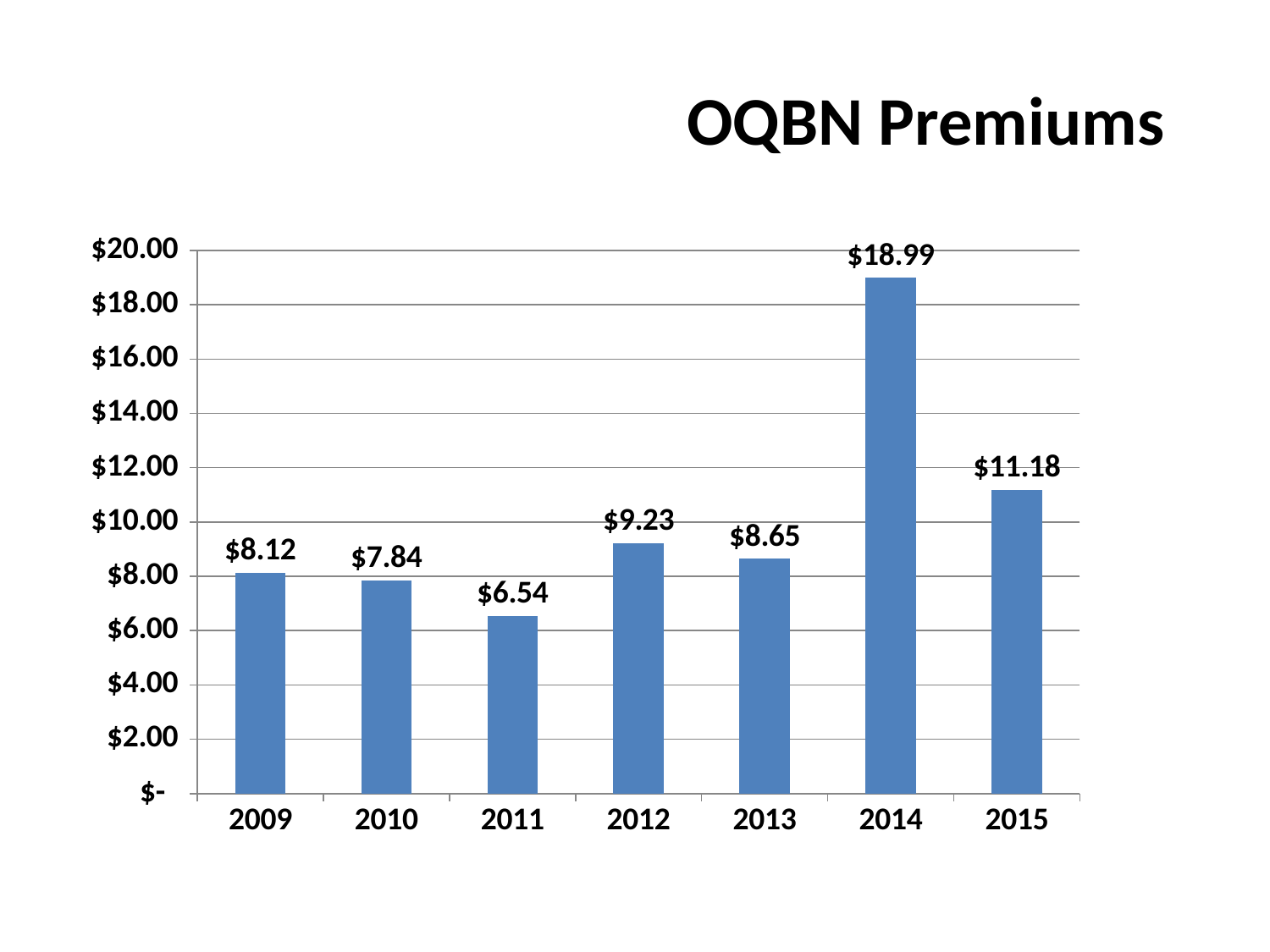
What is the OQBN premium for 2011? $6.54 What is the title of the chart? OQBN Premiums What is the difference between the 2009 and 2010 premiums? $0.28 How many years are shown on the chart? 7 Which year has a larger premium, 2012 or 2013? 2012 What is the OQBN premium for 2014? $18.99 What kind of chart is shown on the slide? Bar chart What is the OQBN premium for 2015? $11.18 Is the value for 2015 greater or less than $10.00? greater What is the difference between the 2014 and 2015 premiums? $7.81 Which year has the highest OQBN premium? 2014 Which year has the lowest OQBN premium? 2011